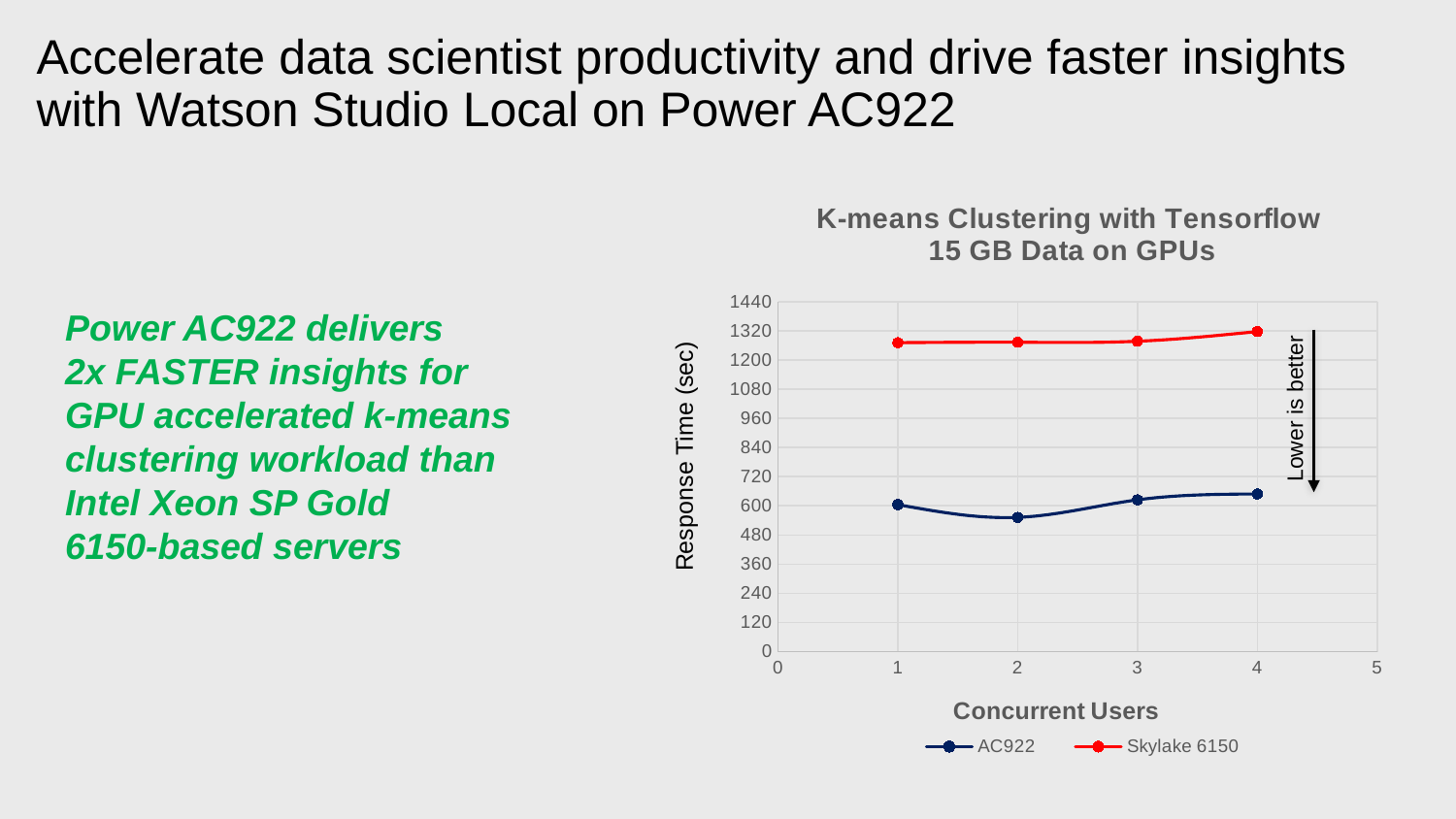
How many series does the legend list? 2 Is the response time for AC922 at 4 concurrent users greater or less than 600? greater Is the response time for Skylake 6150 at 1 concurrent user greater or less than 1200? greater How many data points are plotted for the AC922 series? 4 Does the Skylake 6150 response time rise or fall from 3 to 4 concurrent users? rise At which number of concurrent users is the AC922 response time lowest? 2 At which number of concurrent users is the Skylake 6150 response time highest? 4 At 3 concurrent users, which series has the higher response time, AC922 or Skylake 6150? Skylake 6150 Is the response time for AC922 at 2 concurrent users greater or less than 600? less What kind of chart is shown on the slide? Line chart What is the label of the y axis of the chart? Response Time (sec)